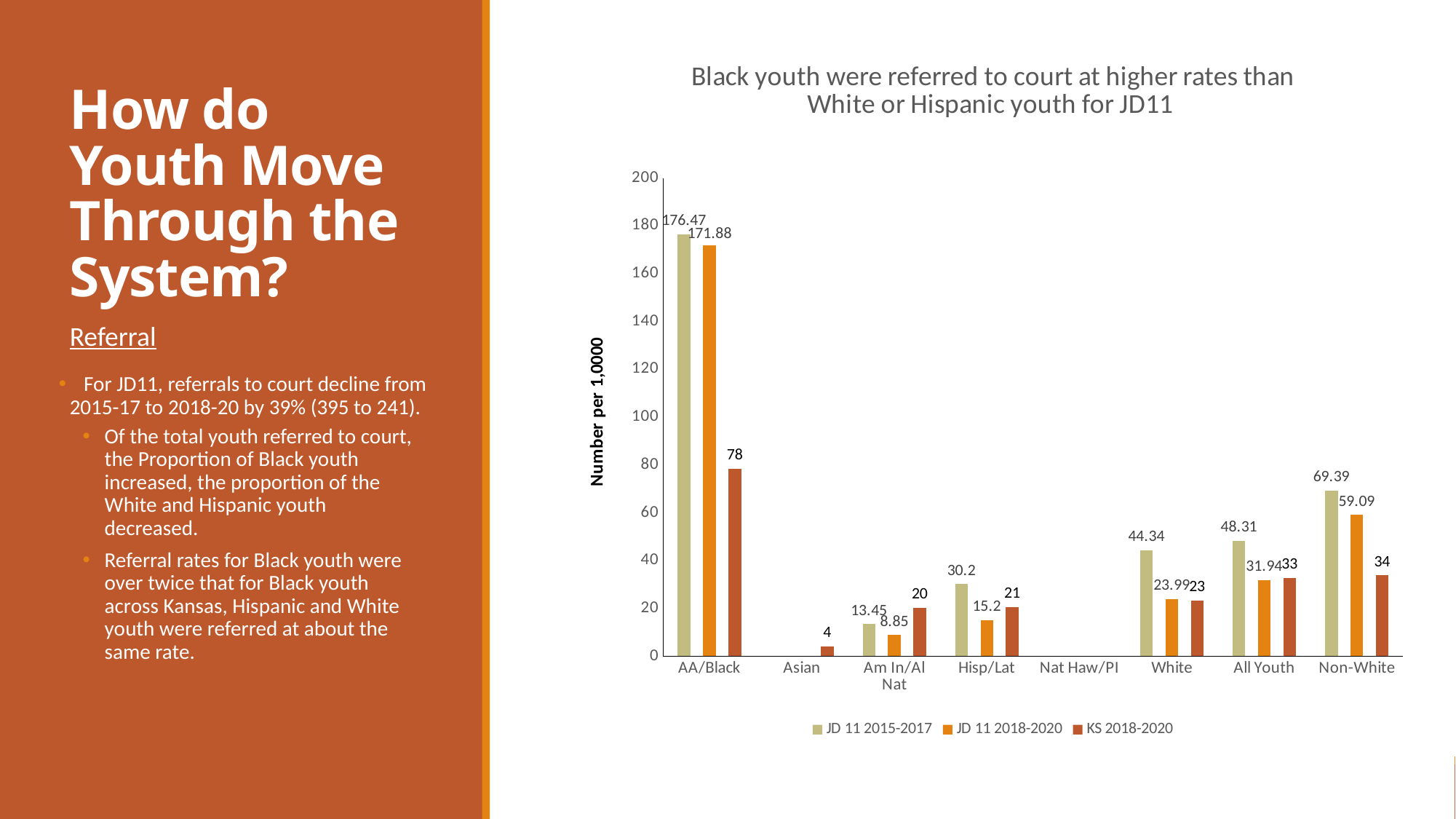
What is the JD 11 2018-2020 value for Non-White? 59.09 How many categories are shown on the x axis? 8 Which category has the highest value in the JD 11 2015-2017 series? AA/Black Which category has the lowest value in the KS 2018-2020 series? Asian What is the JD 11 2015-2017 value for Hisp/Lat? 30.2 How many series does the legend list? 3 In the JD 11 2015-2017 series, which is larger: White or All Youth? All Youth What is the difference between the JD 11 2015-2017 and JD 11 2018-2020 values for AA/Black? 4.59 What is the KS 2018-2020 value for AA/Black? 78 What kind of chart is shown on the slide? Bar chart What is the value for AA/Black in the JD 11 2015-2017 series? 176.47 What is the difference between the JD 11 2015-2017 and KS 2018-2020 values for Non-White? 35.39